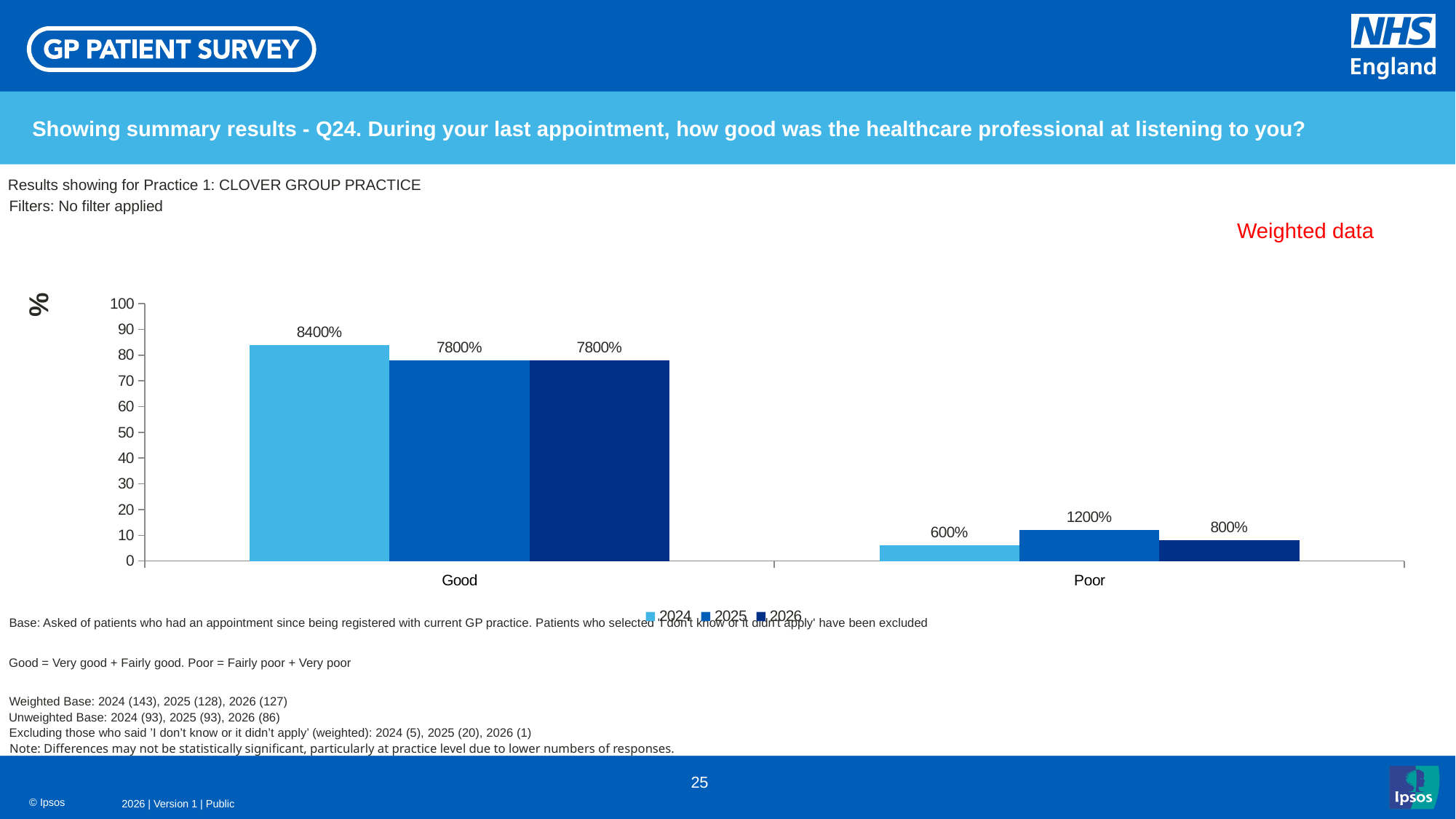
What is the data label for the 2024 series in the Good category? 8400% How many series does the legend list? 3 What are the entries listed in the chart legend? 2024, 2025, 2026 Which year has the lowest value in the Poor category? 2024 Which year has the highest value in the Good category? 2024 How many categories are shown on the x axis? 2 What is the data label for the 2025 series in the Poor category? 1200% What is the difference between the 2024 and 2025 data labels in the Good category? 600% What is the data label for the 2026 series in the Good category? 7800% What is the data label for the 2024 series in the Poor category? 600% In the Poor category, which is larger: the 2025 value or the 2026 value? 2025 What kind of chart is shown on the slide? Bar chart